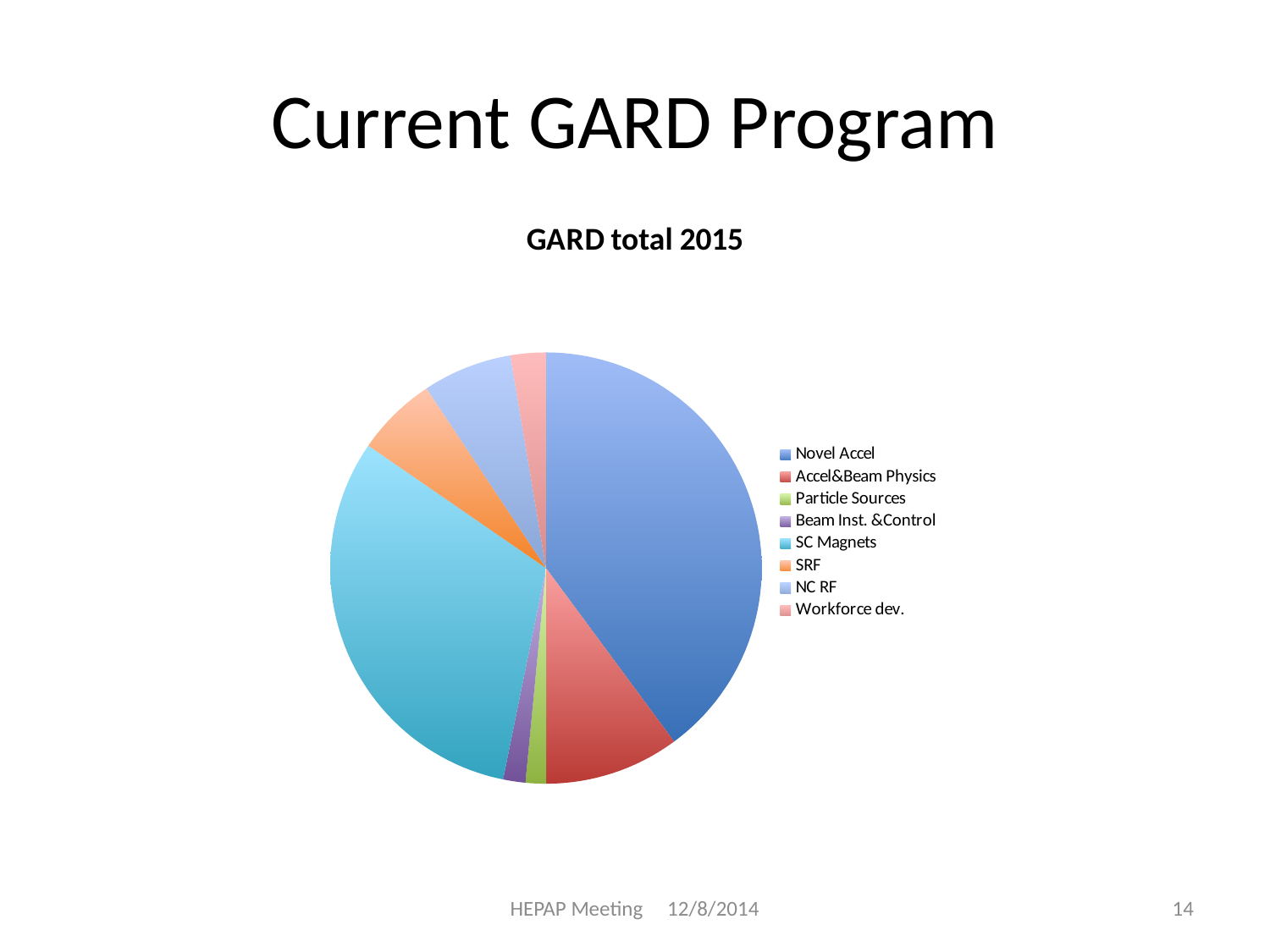
Which category has the largest slice of the pie? Novel Accel Which slice is larger, SC Magnets or SRF? SC Magnets Which slice is larger, Novel Accel or Accel&Beam Physics? Novel Accel How many categories (slices) does the pie chart have? 8 Which slice is larger, Accel&Beam Physics or NC RF? Accel&Beam Physics Which category is shown in green in the pie chart? Particle Sources What kind of chart is shown on the slide? pie chart What is the title of the chart? GARD total 2015